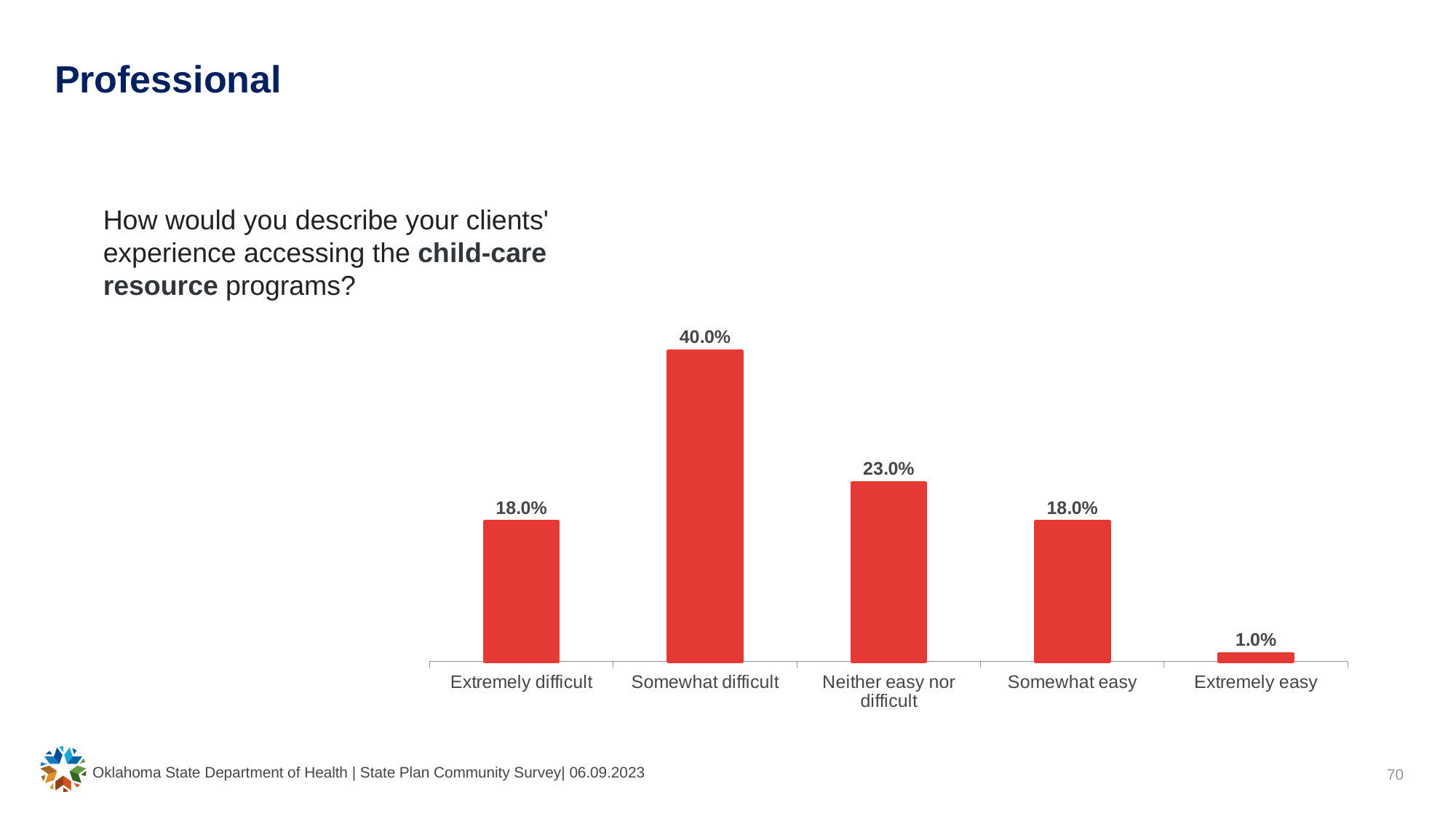
Which is larger, the value for Neither easy nor difficult or the value for Somewhat easy? Neither easy nor difficult What percentage of respondents said their clients' experience accessing child-care resource programs was Somewhat difficult? 40.0% What is the difference between the values for Somewhat easy and Extremely easy? 17.0% What is the value shown for Extremely difficult? 18.0% What colour are the bars in the chart? Red Which category has the highest value? Somewhat difficult What is the value shown for Neither easy nor difficult? 23.0% How many categories are shown on the x axis of the chart? 5 What is the value shown for Extremely easy? 1.0% What kind of chart is shown on the slide? Bar chart What is the difference between the values for Somewhat difficult and Neither easy nor difficult? 17.0% Which category has the lowest value? Extremely easy